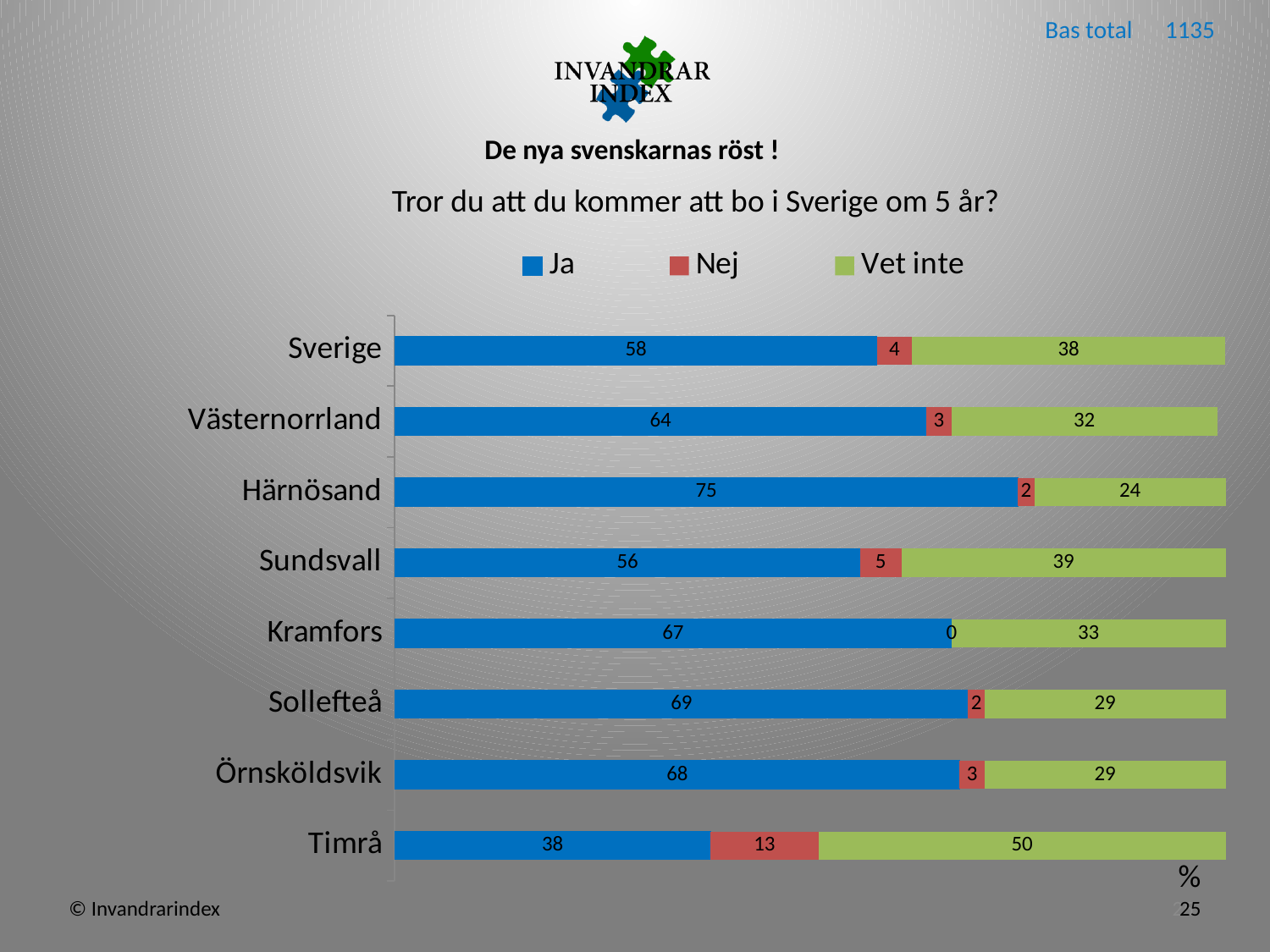
What is the 'Nej' value for Timrå? 13 What is the 'Vet inte' value for Sundsvall? 39 How many categories are shown on the chart? 8 Which is larger, the 'Vet inte' value for Timrå or for Sverige? Timrå How many series does the legend list? 3 Which category has the lowest 'Ja' value? Timrå What kind of chart is shown on the slide? Stacked bar chart Which category has the highest 'Ja' value? Härnösand What is the 'Ja' value for Härnösand? 75 What is the 'Nej' value for Kramfors? 0 What is the total of the stacked bar for Kramfors? 100 What is the difference between the 'Ja' values for Västernorrland and Sverige? 6